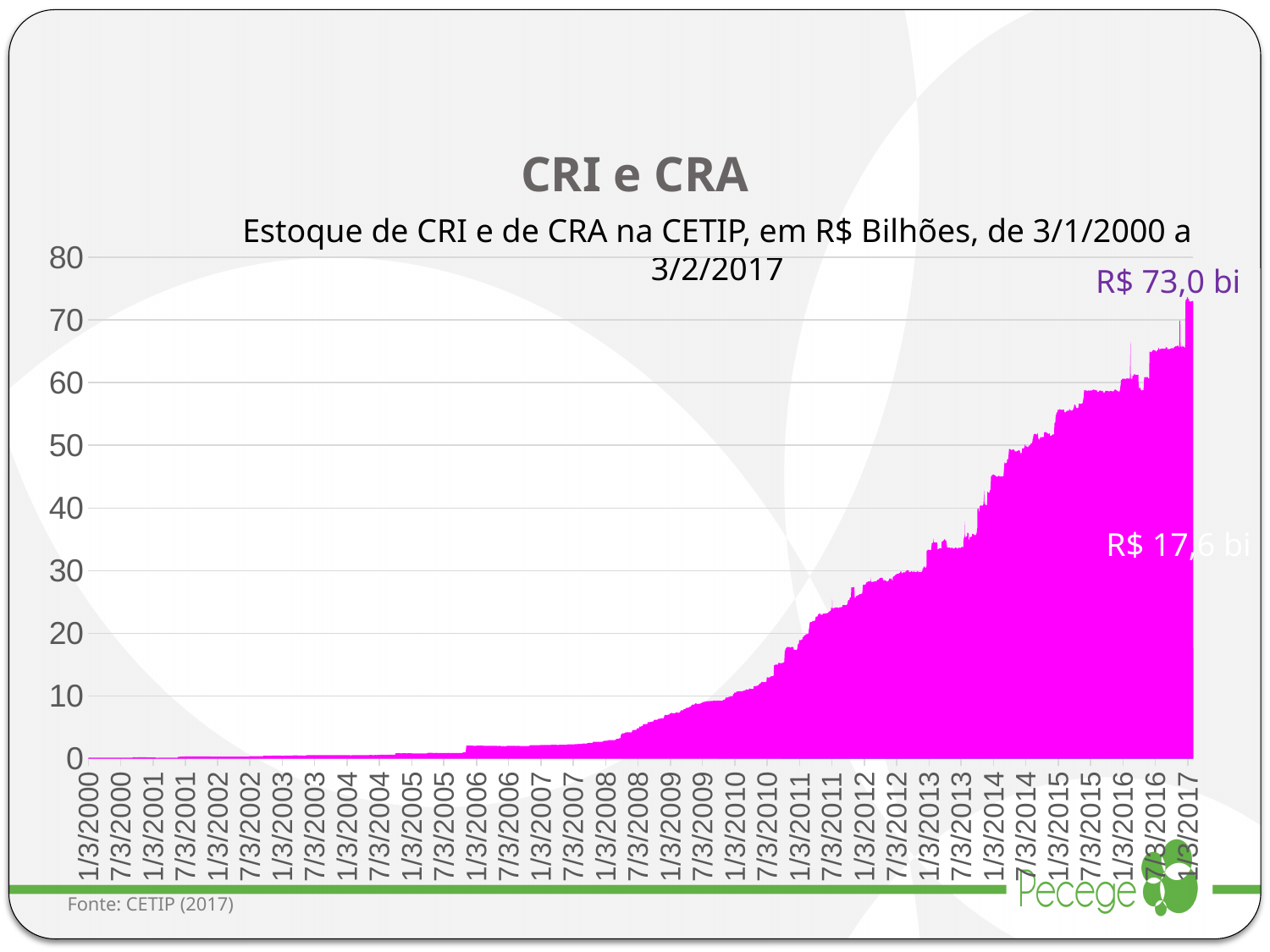
Is the value at 1/3/2016 greater or less than 50? greater What kind of chart is shown on the slide? area chart Is the value at 1/3/2014 greater or less than 40? greater Which two values are labelled on the chart? R$ 73,0 bi and R$ 17,6 bi What is the highest value shown on the y axis? 80 Do the values rise or fall along the x axis from 2000 to 2017? rise What value is labelled at the end of the series, at the top right of the chart? R$ 73,0 bi At which date on the x axis does the series reach its highest value? 1/3/2017 Is the value at 1/3/2012 greater or less than 20? greater What is the title of the chart? Estoque de CRI e de CRA na CETIP, em R$ Bilhões, de 3/1/2000 a 3/2/2017